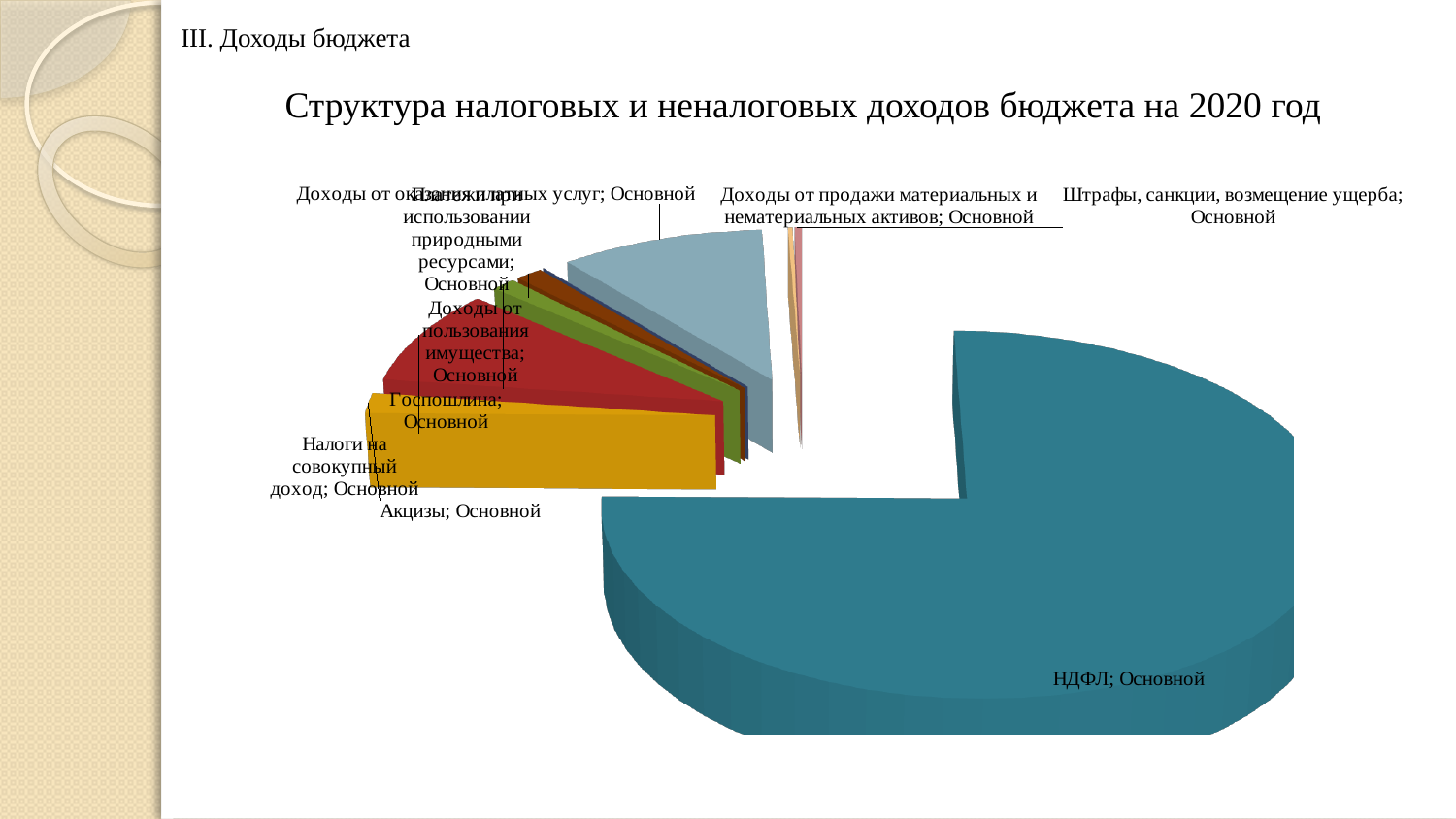
What kind of chart is shown on the slide? pie chart Which year does the chart describe? 2020 Which slice is larger, НДФЛ or Доходы от оказания платных услуг? НДФЛ Which category has the largest slice of the pie? НДФЛ What is the title of the chart? Структура налоговых и неналоговых доходов бюджета на 2020 год What colour is the НДФЛ slice? teal How many categories (slices) are labelled in the pie chart? 9 Which slice is larger, НДФЛ or Акцизы? НДФЛ Which slice is larger, Доходы от оказания платных услуг or Штрафы, санкции, возмещение ущерба? Доходы от оказания платных услуг